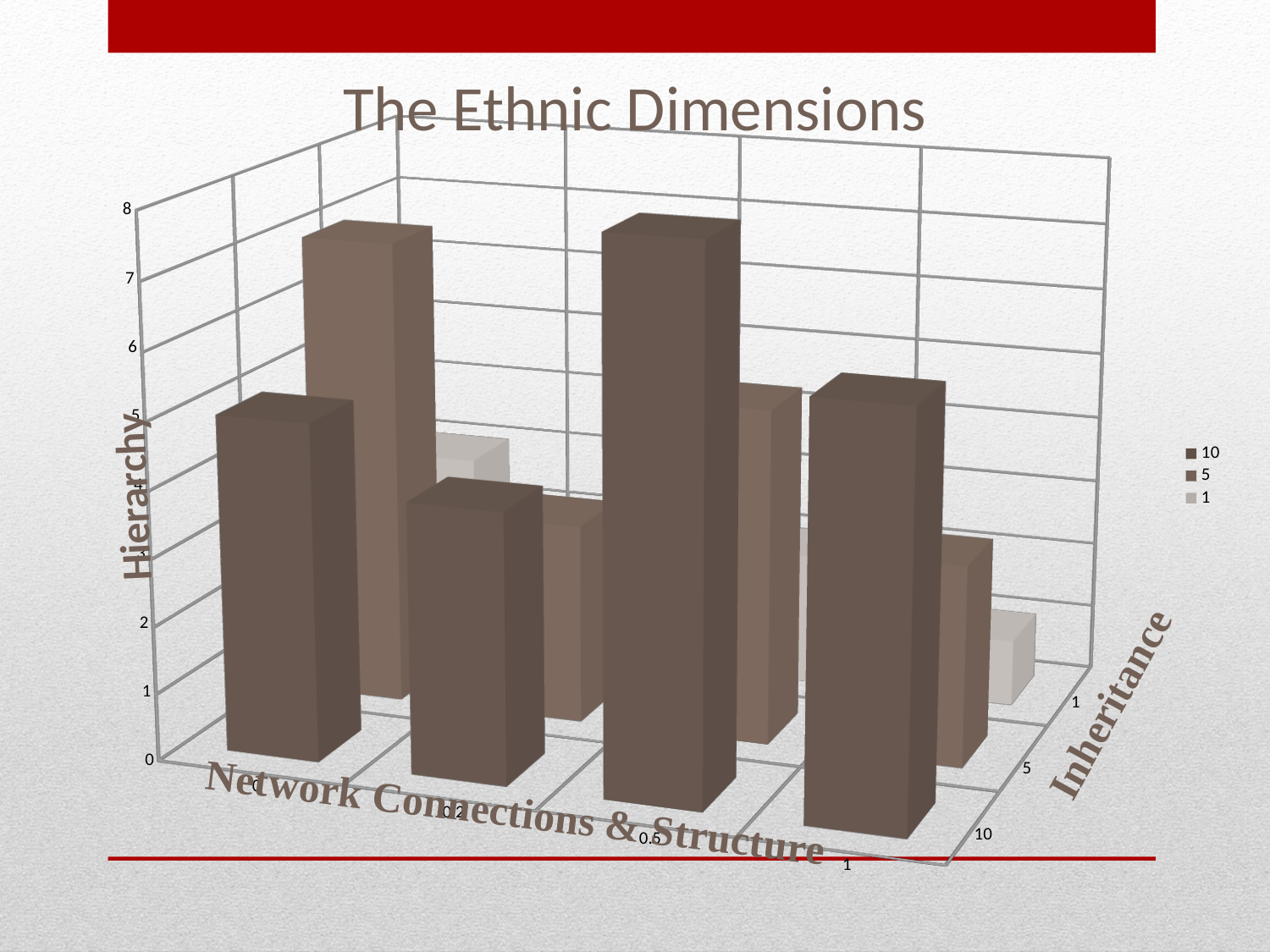
What kind of chart is shown on the slide? bar chart Is the value for category 0.2 in the series labelled 10 greater or less than 6? less In the series labelled 10, which is larger: the bar for category 0 or the bar for category 0.2? 0 Is the value for category 0.5 in the series labelled 10 greater or less than 5? greater What is the label on the vertical axis? Hierarchy In the series labelled 5, which Network Connections & Structure category has the highest bar? 0 Is the value for category 0 in the series labelled 5 greater or less than 5? greater How many series does the legend list? 3 In the series labelled 10, which Network Connections & Structure category has the highest bar? 0.5 How many categories are shown along the Network Connections & Structure axis? 4 In the series labelled 10, which Network Connections & Structure category has the lowest bar? 0.2 What is the title of the chart? The Ethnic Dimensions